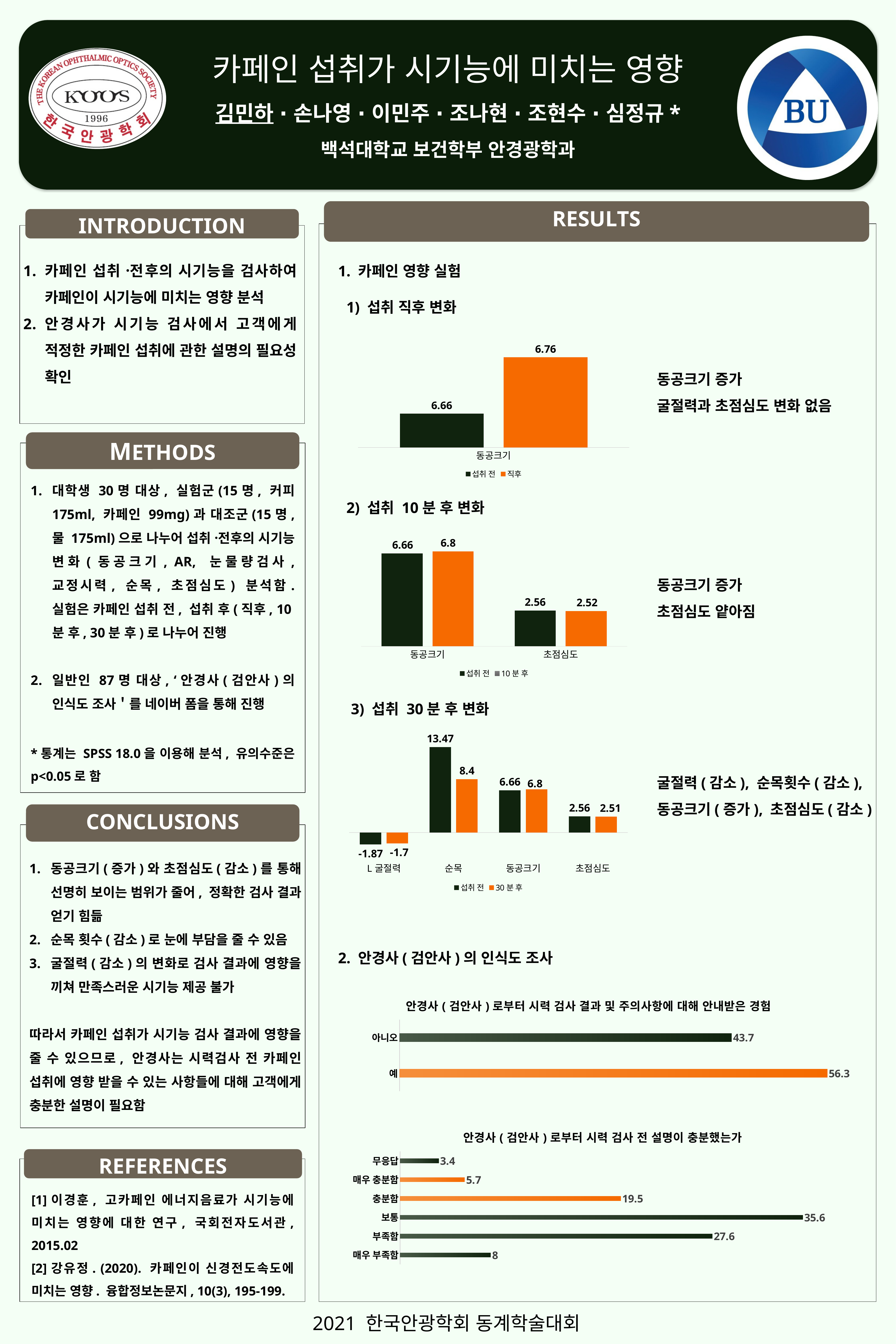
In the '섭취 30분 후 변화' chart, how many categories are shown on the x axis? 4 In the '안경사(검안사)로부터 시력 검사 전 설명이 충분했는가' chart, what is the difference between 부족함 and 충분함? 8.1 In the '섭취 10분 후 변화' chart, what is the value of 초점심도 for 10분 후? 2.52 In the '섭취 직후 변화' chart, what is the difference between the 직후 and 섭취 전 values for 동공크기? 0.1 In the '섭취 직후 변화' chart, what is the value of 동공크기 for 직후? 6.76 In the '안경사(검안사)로부터 시력 검사 전 설명이 충분했는가' chart, which category has the highest value? 보통 In the '섭취 30분 후 변화' chart, which category has the highest 섭취 전 value? 순목 In the '섭취 30분 후 변화' chart, what is the 30분 후 value for L 굴절력? -1.7 In the '안경사(검안사)로부터 시력 검사 결과 및 주의사항에 대해 안내받은 경험' chart, what is the value for 예? 56.3 In the '섭취 10분 후 변화' chart, how many series does the legend list? 2 In the '안경사(검안사)로부터 시력 검사 결과 및 주의사항에 대해 안내받은 경험' chart, what kind of chart is it? Bar chart In the '섭취 30분 후 변화' chart, what is the 섭취 전 value for 순목? 13.47